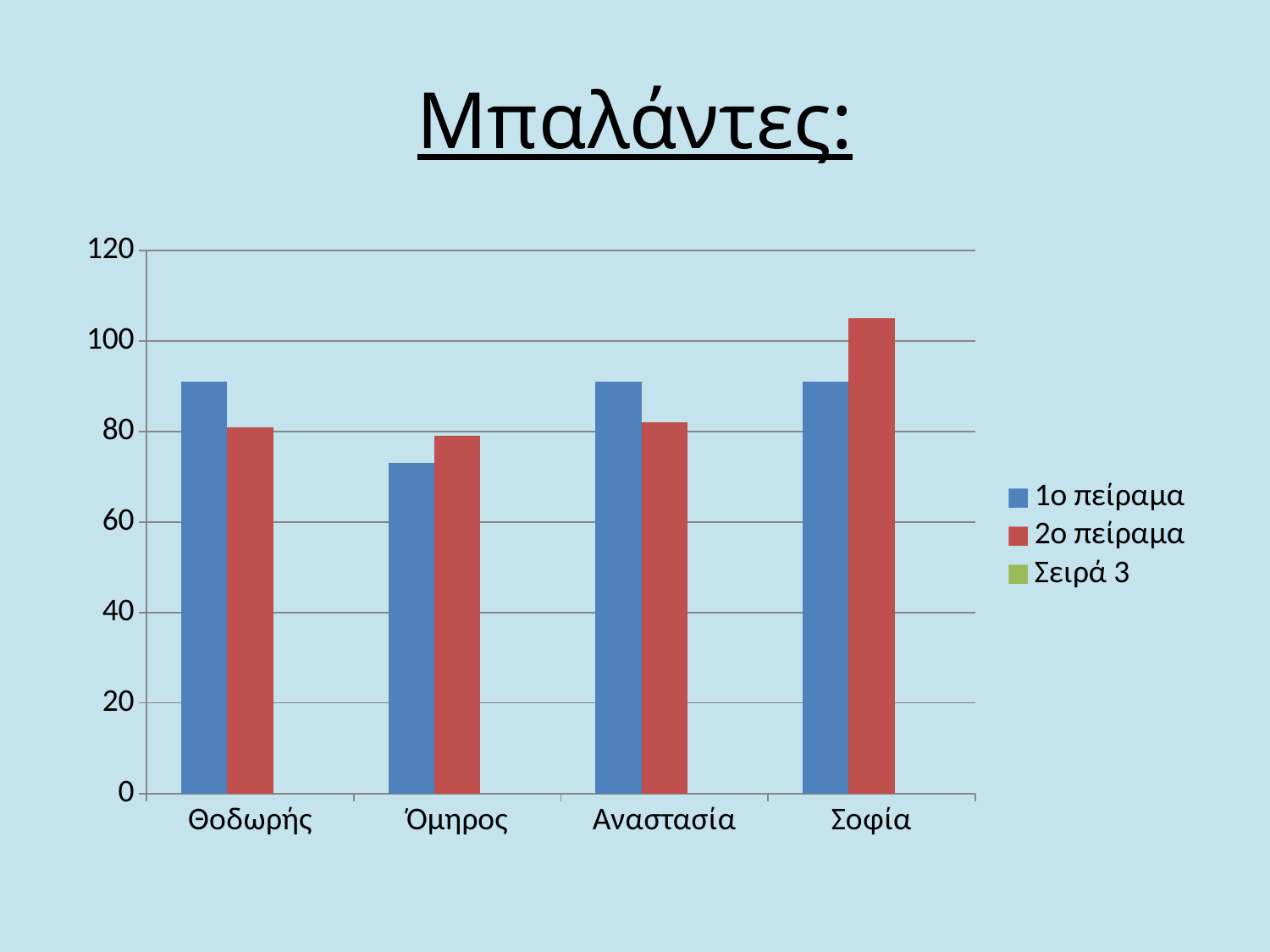
Which category has the lowest value for 1ο πείραμα? Όμηρος How many categories are shown on the x axis? 4 Is the value for Θοδωρής in 1ο πείραμα greater or less than 80? greater Is the value for Σοφία in 2ο πείραμα greater or less than 100? greater Which colour represents 2ο πείραμα in the legend? red For Σοφία, which series has the larger value, 1ο πείραμα or 2ο πείραμα? 2ο πείραμα What kind of chart is shown on the slide? bar chart Is the value for Όμηρος in 1ο πείραμα greater or less than 80? less Which category has the highest value for 2ο πείραμα? Σοφία For Θοδωρής, which series has the larger value, 1ο πείραμα or 2ο πείραμα? 1ο πείραμα How many series does the legend list? 3 What is the title of the slide? Μπαλάντες: